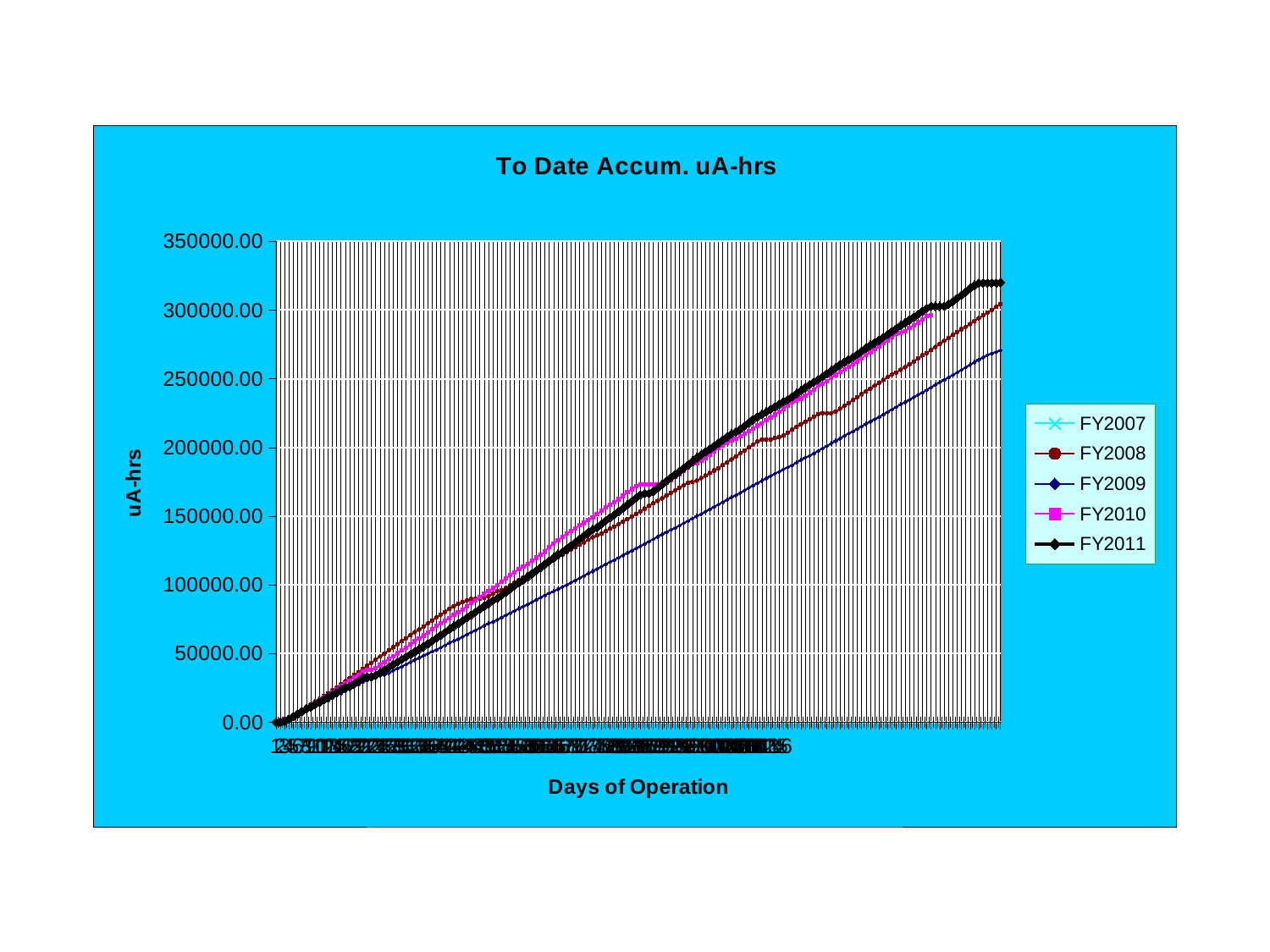
How many series does the legend list? 5 Do the values for FY2011 rise or fall as the days of operation increase? rise Do the values for FY2009 rise or fall along the x axis? rise What is the title of the chart? To Date Accum. uA-hrs Which series reaches the highest accumulated uA-hrs on the chart? FY2011 At the end of the plotted period, which series is higher, FY2011 or FY2009? FY2011 Is the final value for FY2011 greater or less than 250000.00? greater Is the final value for FY2009 greater or less than 300000.00? less Is the final value for FY2011 greater or less than 300000.00? greater What kind of chart is shown on the slide? line chart What is the label on the x axis of the chart? Days of Operation